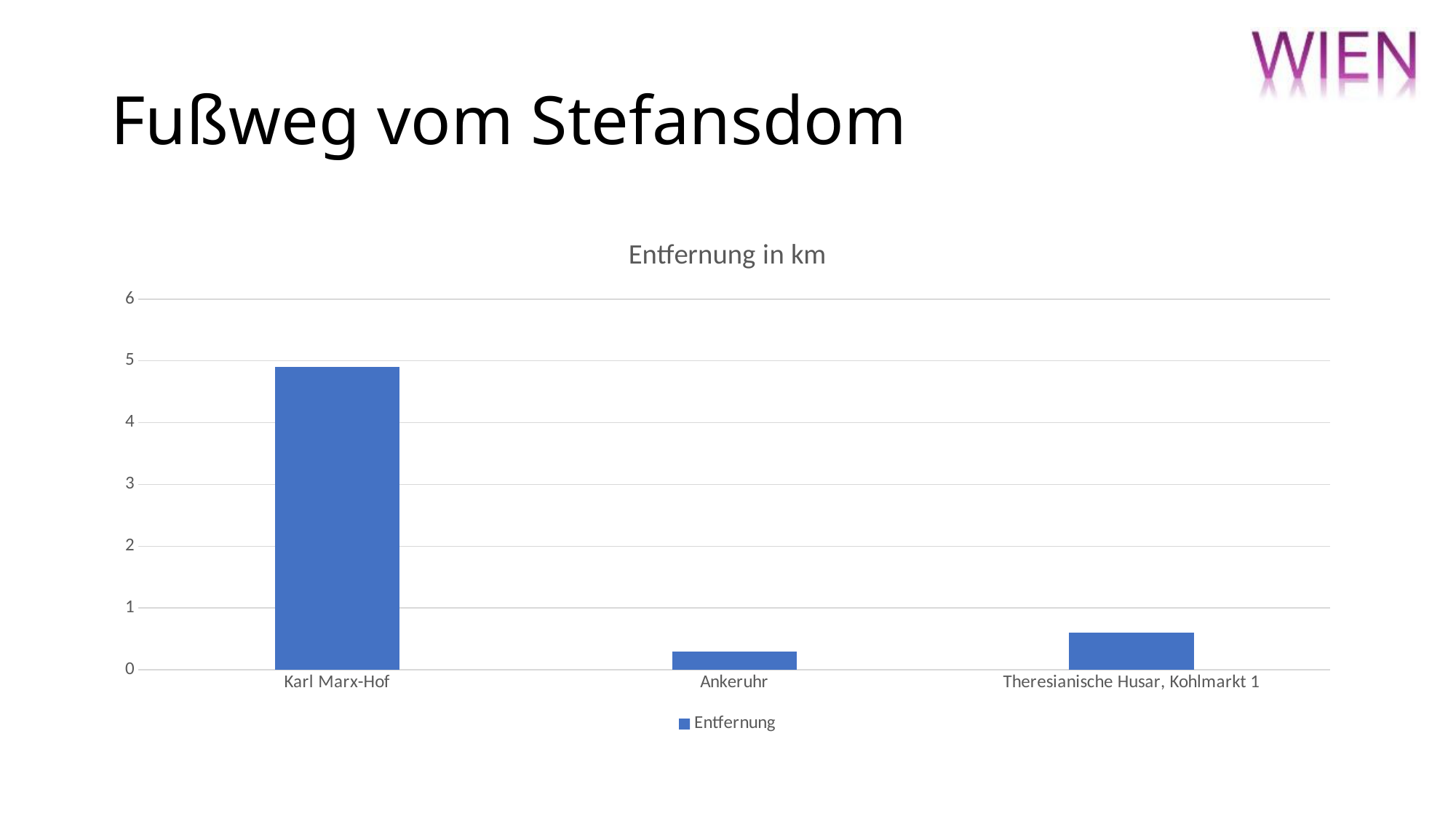
What kind of chart is shown on the slide? bar chart Which category has the lowest value in the chart? Ankeruhr What is the name of the series listed in the legend? Entfernung Which has a larger value, Karl Marx-Hof or Ankeruhr? Karl Marx-Hof How many series does the chart's legend list? 1 Is the value for Karl Marx-Hof greater or less than 4? greater Which category has the highest value in the chart? Karl Marx-Hof How many categories are shown on the x axis of the chart? 3 Is the value for Theresianische Husar, Kohlmarkt 1 greater or less than 1? less What is the title of the chart? Entfernung in km Which has a larger value, Ankeruhr or Theresianische Husar, Kohlmarkt 1? Theresianische Husar, Kohlmarkt 1 Is the value for Ankeruhr greater or less than 1? less